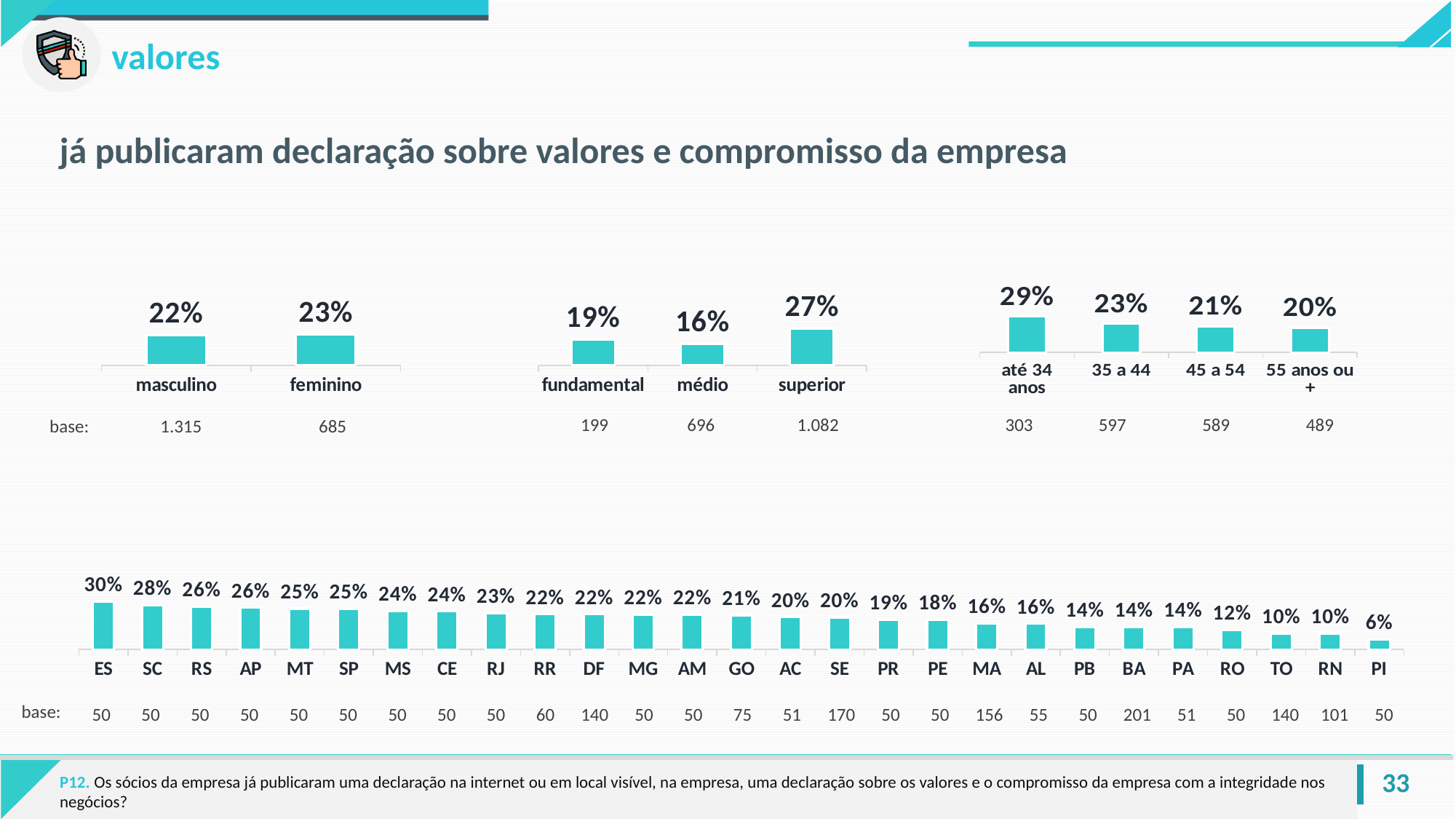
In the age group chart (top right), how many age categories are shown? 4 In the education chart (top middle), which category has the lowest value? médio What kind of chart is the state chart at the bottom of the slide? bar chart In the state chart at the bottom, which state has the highest value? ES In the gender chart (top left), what is the value for feminino? 23% In the age group chart (top right), what is the value for até 34 anos? 29% In the state chart at the bottom, which is larger, the value for SC or the value for RO? SC In the age group chart (top right), do the values rise or fall from left to right? fall In the education chart (top middle), which category has the highest value? superior In the state chart at the bottom, which state has the lowest value? PI In the state chart at the bottom, what is the value for MA? 16% In the education chart (top middle), what is the difference between superior and médio? 11 percentage points